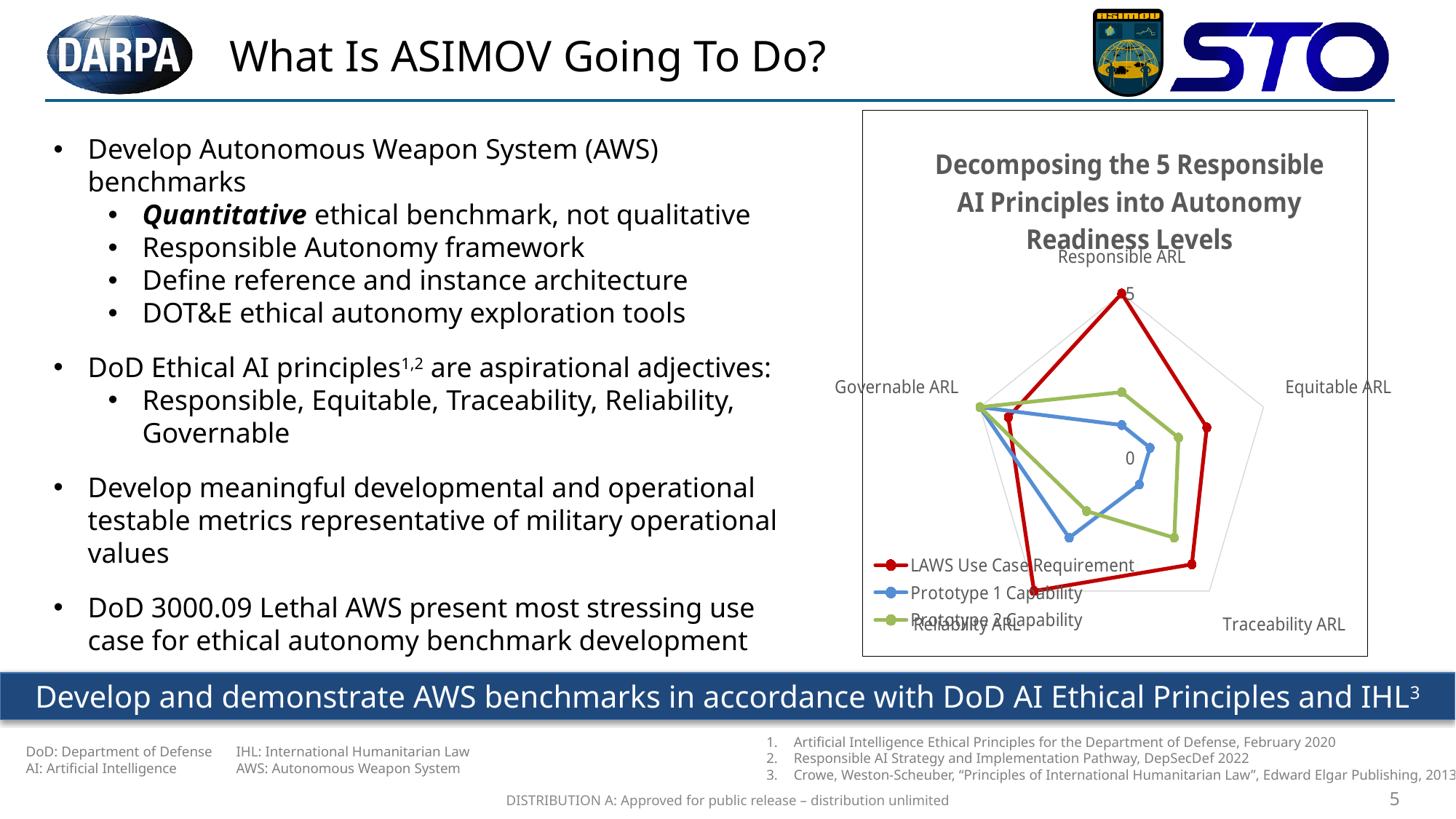
On the Traceability ARL axis, which is larger: LAWS Use Case Requirement or Prototype 1 Capability? LAWS Use Case Requirement How many series does the chart legend list? 3 Which series has the highest value on the Responsible ARL axis? LAWS Use Case Requirement Which series has the lowest value on the Responsible ARL axis? Prototype 1 Capability Is the value of Prototype 1 Capability on the Responsible ARL axis greater or less than 5? less Which colour represents the LAWS Use Case Requirement series? Red What is the title of the chart on the slide? Decomposing the 5 Responsible AI Principles into Autonomy Readiness Levels What kind of chart is shown on the slide? Radar chart On which axis does Prototype 2 Capability reach its highest value? Governable ARL What is the value of LAWS Use Case Requirement on the Responsible ARL axis? 5 On which axis does Prototype 1 Capability reach its highest value? Governable ARL How many axes (ARL categories) does the radar chart have? 5